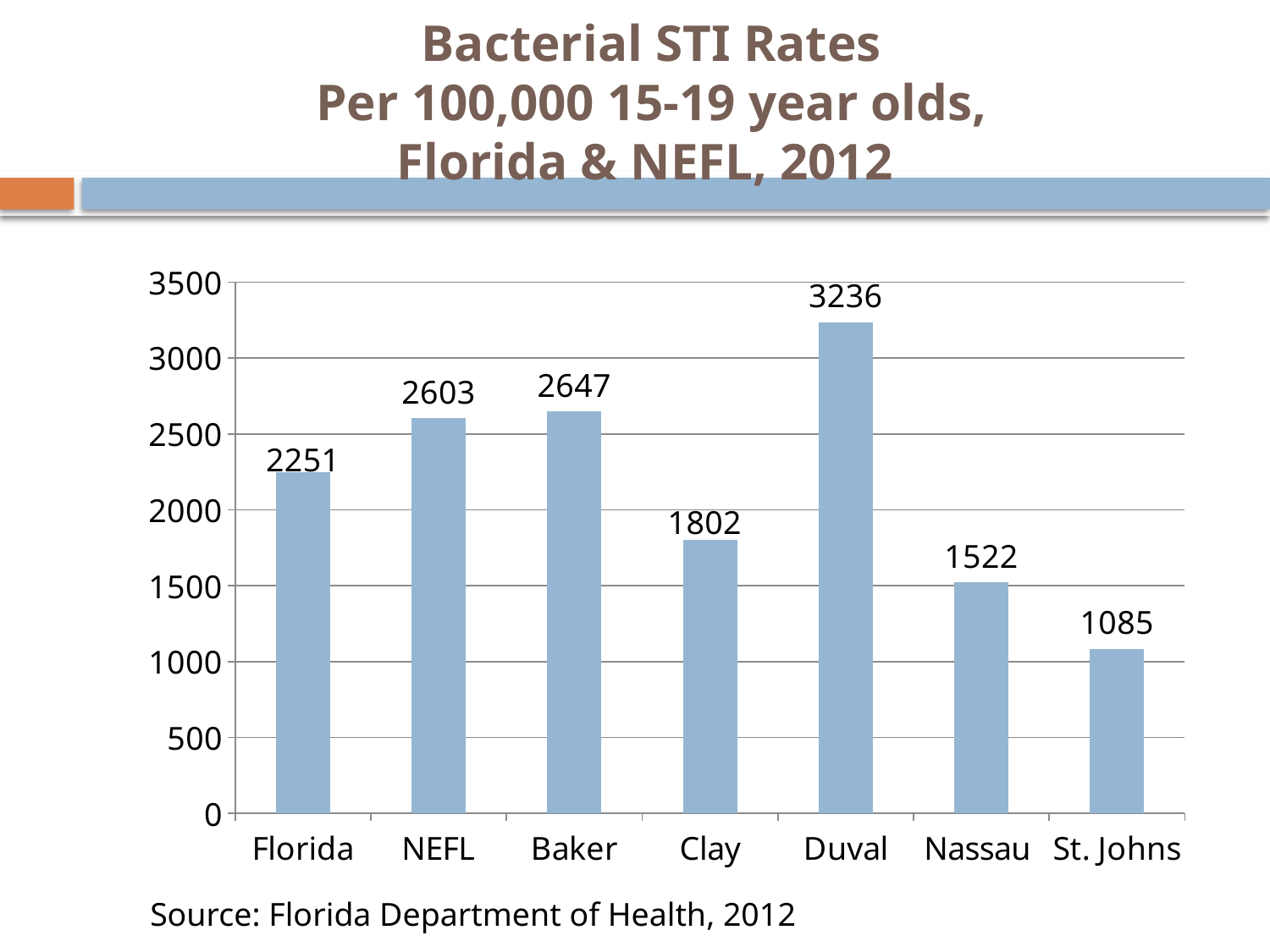
What source is cited below the chart? Florida Department of Health, 2012 How many categories are shown on the x axis? 7 Which category has the highest bacterial STI rate? Duval What is the difference between the rates for Duval and Florida? 985 Is the value for Nassau greater or less than 2000? less What is the bacterial STI rate for St. Johns? 1085 What is the bacterial STI rate for Florida? 2251 Which has a higher bacterial STI rate, NEFL or Clay? NEFL What kind of chart is shown on the slide? Bar chart Which category has the lowest bacterial STI rate? St. Johns What is the bacterial STI rate for Duval? 3236 What is the difference between the rates for Clay and Nassau? 280